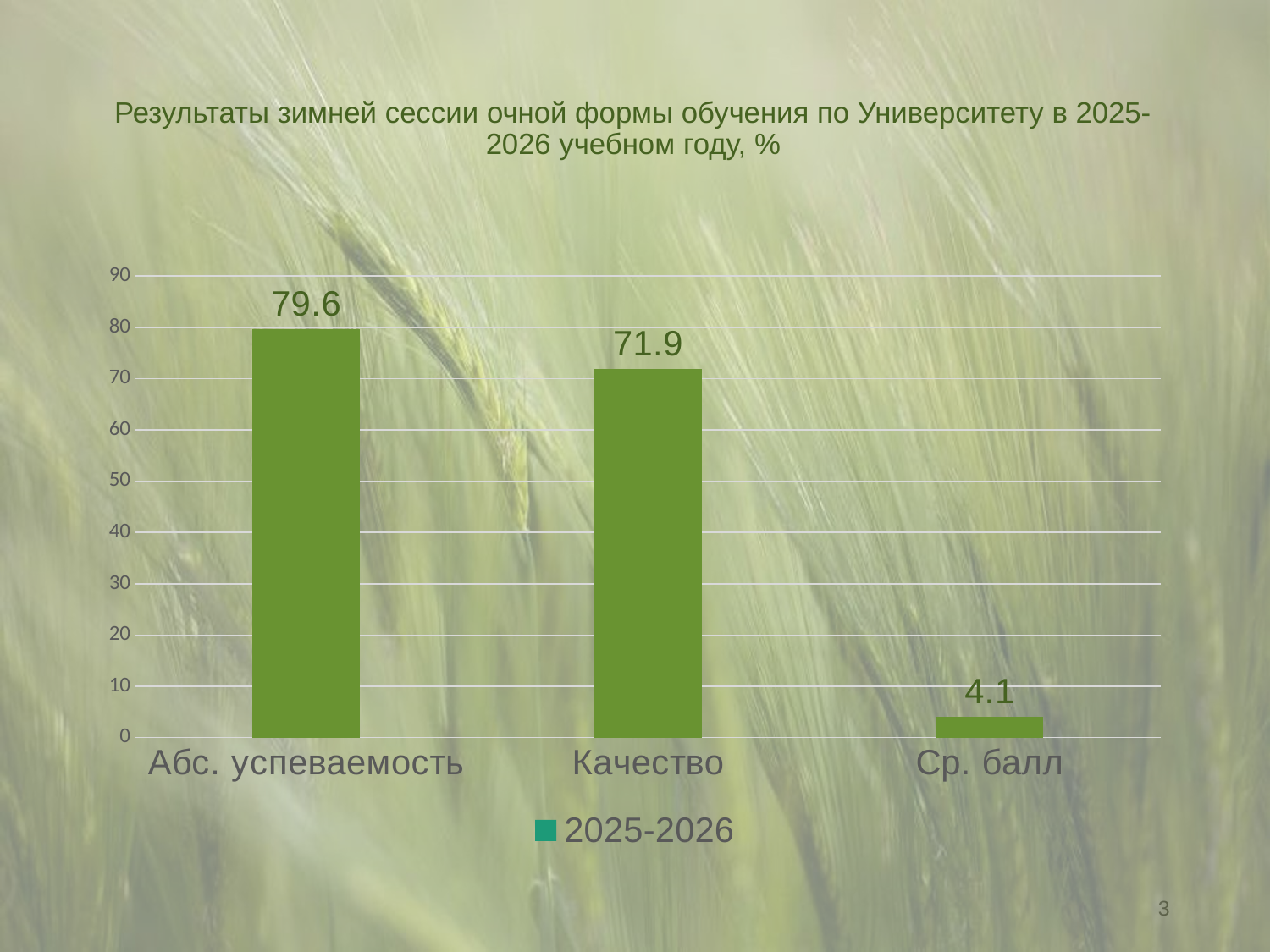
How many categories are shown on the x axis? 3 Is the value for Качество greater or less than 70? greater How many series does the legend list? 1 Which is larger, the value for Качество or the value for Ср. балл? Качество What is the value for Ср. балл? 4.1 What is the value for Абс. успеваемость? 79.6 Which category has the lowest value? Ср. балл What kind of chart is shown on the slide? bar chart What is the difference between the values for Абс. успеваемость and Качество? 7.7 What is the value for Качество? 71.9 Which category has the highest value? Абс. успеваемость What series name is shown in the legend? 2025-2026